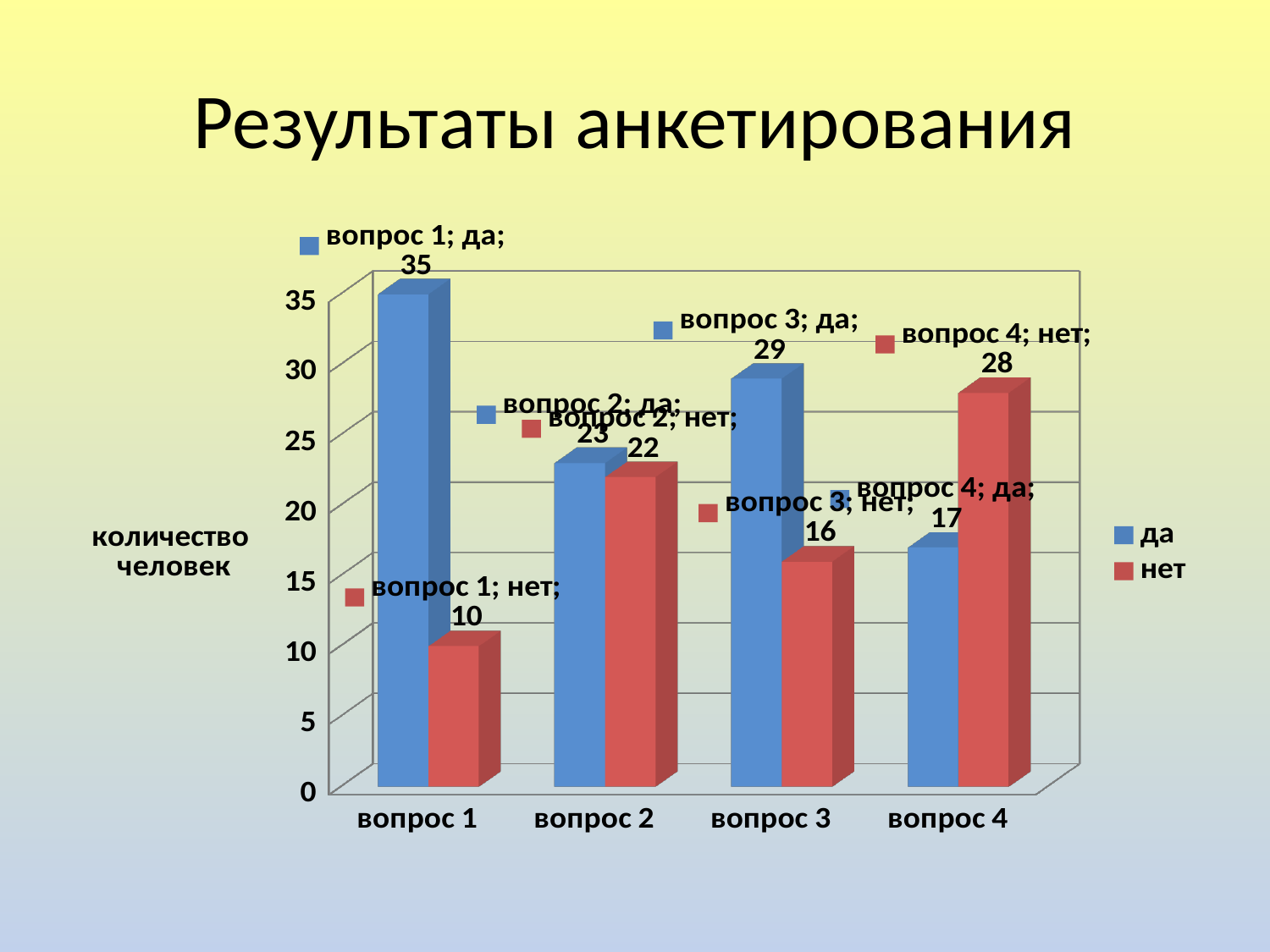
Which question has the lowest "нет" value? вопрос 1 What is the difference between the "да" and "нет" values for вопрос 1? 25 Which question has the highest "да" value? вопрос 1 What is the value for "нет" for вопрос 4? 28 What is the value for "да" for вопрос 2? 23 What is the value for "нет" for вопрос 3? 16 What kind of chart is shown on the slide? bar chart What is the difference between the "нет" values for вопрос 4 and вопрос 3? 12 What is the value for "да" for вопрос 1? 35 For вопрос 4, which is larger, "да" or "нет"? нет How many series does the legend list? 2 How many questions (categories) are shown on the x axis? 4